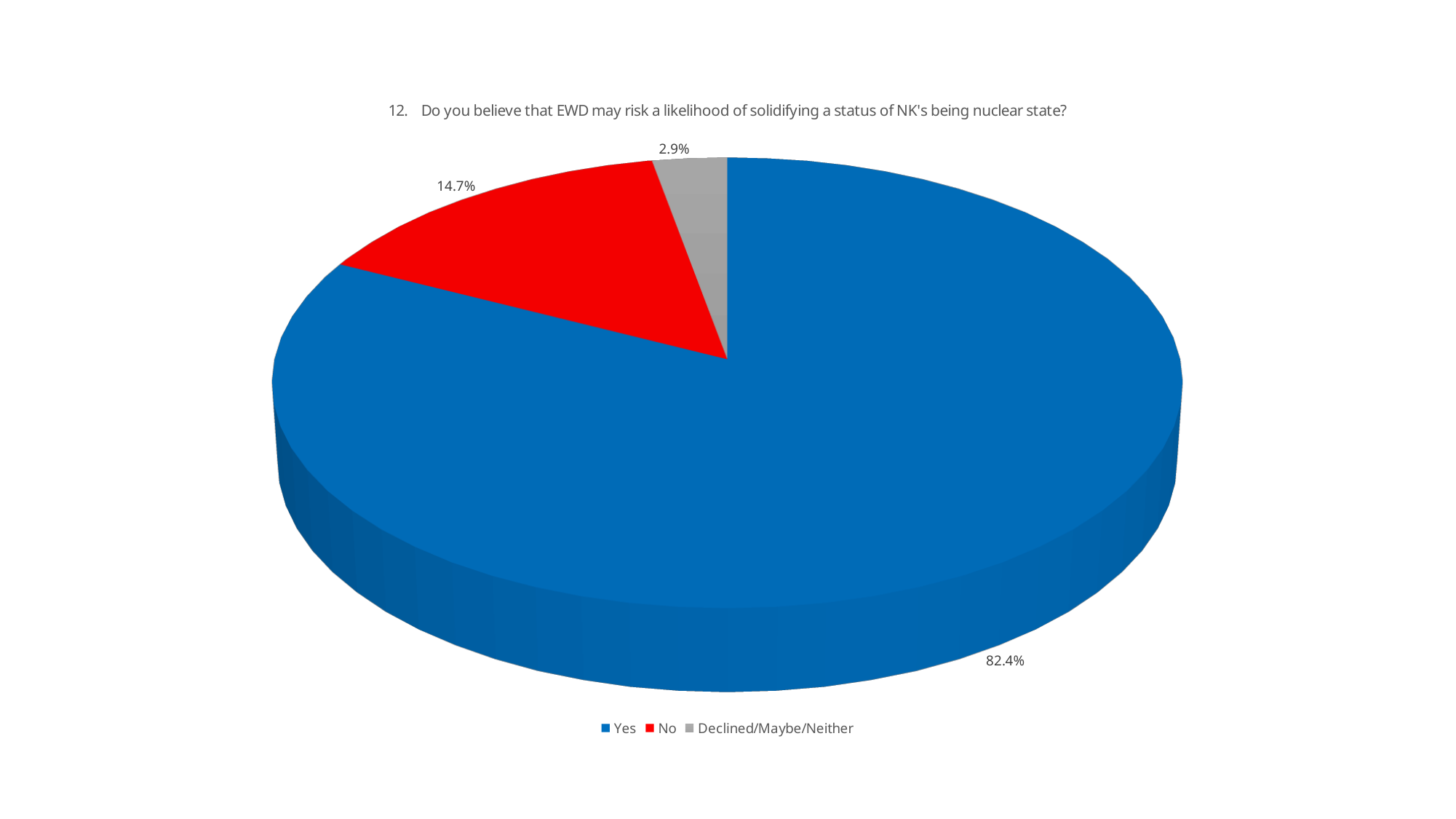
What percentage of respondents answered Yes? 82.4% What percentage of respondents answered No? 14.7% What is the difference in percentage points between the Yes and No shares? 67.7 How many categories does the pie chart have? 3 What type of chart is shown on the slide? Pie chart Which is larger, the share for No or the share for Declined/Maybe/Neither? No Which response has the smallest share of the pie? Declined/Maybe/Neither What is the title of the chart? 12. Do you believe that EWD may risk a likelihood of solidifying a status of NK's being nuclear state? Which response has the largest share of the pie? Yes What percentage of respondents are in the Declined/Maybe/Neither category? 2.9% What is the difference in percentage points between the No and Declined/Maybe/Neither shares? 11.8 What colour is the Yes slice? Blue